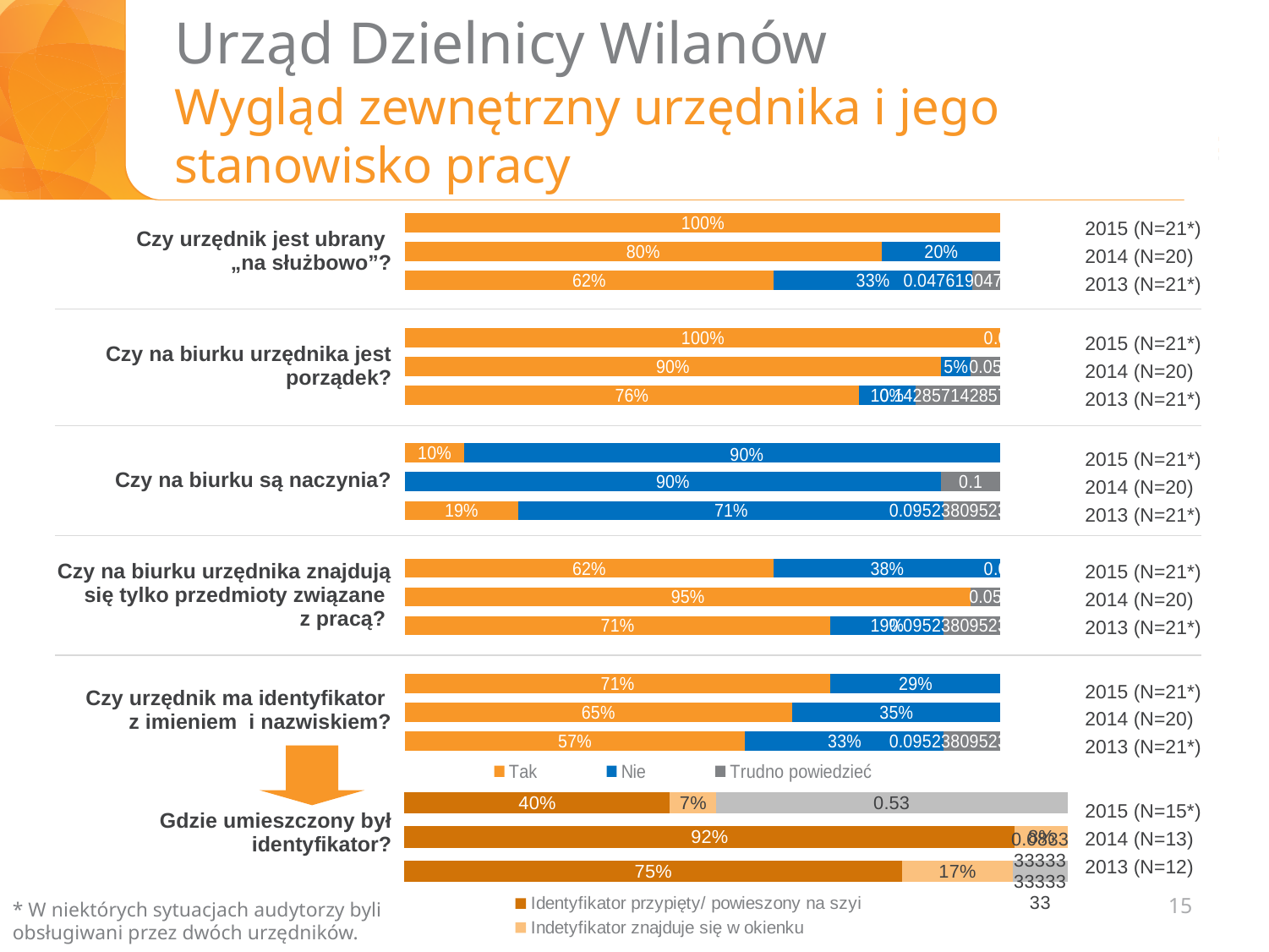
In the chart "Czy urzędnik ma identyfikator z imieniem i nazwiskiem?", does the Tak share rise or fall from 2013 to 2015? rise In the chart "Czy urzędnik jest ubrany „na służbowo”?", what is the difference between the Tak share in 2014 (N=20) and in 2013 (N=21*)? 18% In the chart "Czy urzędnik ma identyfikator z imieniem i nazwiskiem?", what percentage answered Nie in 2014 (N=20)? 35% In the chart "Gdzie umieszczony był identyfikator?", what percentage had the identifier pinned/hung on the neck in 2014 (N=13)? 92% In the chart "Czy urzędnik jest ubrany „na służbowo”?", what percentage answered Tak in 2015 (N=21*)? 100% In the chart "Czy na biurku są naczynia?", what percentage answered Tak in 2015 (N=21*)? 10% In the chart "Czy na biurku urzędnika znajdują się tylko przedmioty związane z pracą?", is the Tak share larger in 2014 (N=20) or in 2015 (N=21*)? 2014 (N=20) How many series does the legend with Tak, Nie and Trudno powiedzieć list? 3 In the chart "Czy urzędnik jest ubrany „na służbowo”?", what percentage answered Nie in 2014 (N=20)? 20% In the chart "Czy na biurku są naczynia?", which year has the lowest Nie share? 2013 (N=21*) In the chart "Czy na biurku urzędnika jest porządek?", which year has the highest Tak share? 2015 (N=21*) In the chart "Czy na biurku urzędnika jest porządek?", what percentage answered Tak in 2013 (N=21*)? 76%